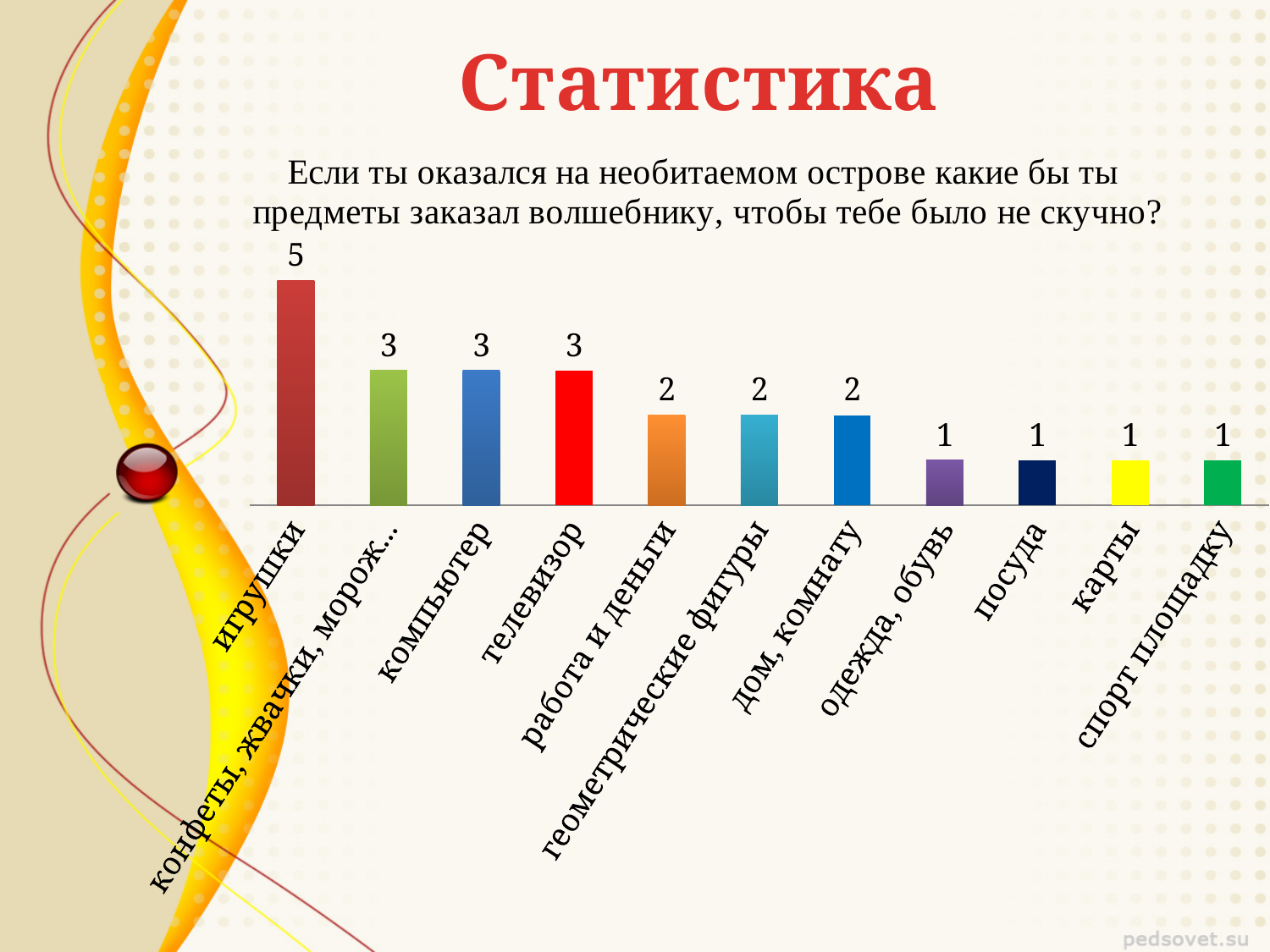
How many categories are shown in the chart? 11 What value is shown for дом, комнату? 2 What is the difference between the values for игрушки and телевизор? 2 What kind of chart is shown on the slide? bar chart What is the title of the slide containing the chart? Статистика Which category has the highest value? игрушки Do the values rise or fall from left to right along the x axis? fall What value is shown for игрушки? 5 What is the difference between the values for работа и деньги and карты? 1 What value is shown for компьютер? 3 Which is larger, the value for компьютер or the value for геометрические фигуры? компьютер What value is shown for посуда? 1